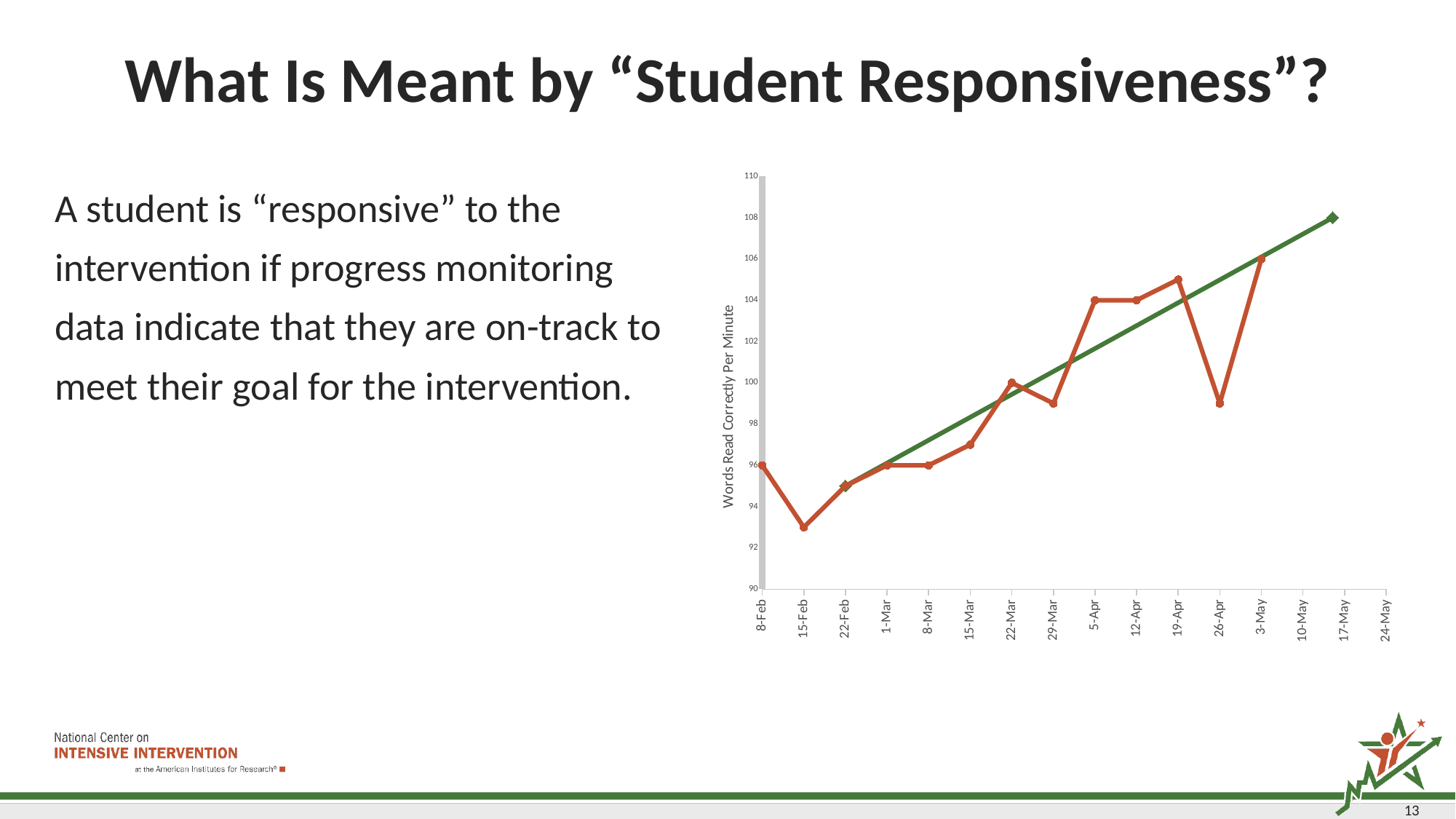
Is the value of the red line for 15-Feb greater or less than 94? less Which has the larger value on the red line, 22-Mar or 29-Mar? 22-Mar What is the title of the vertical axis of the chart? Words Read Correctly Per Minute What kind of chart is shown on the slide? line chart Overall, does the red progress-monitoring line rise or fall from 8-Feb to 3-May? rise How many dates are labelled along the x axis of the chart? 16 What value does the green goal line reach at 17-May? 108 What value does the red line show for 22-Mar? 100 On which date does the red progress-monitoring line reach its lowest value? 15-Feb Is the value of the red line for 26-Apr greater or less than 100? less What value does the red line show for 5-Apr? 104 On which date does the red progress-monitoring line reach its highest value? 3-May